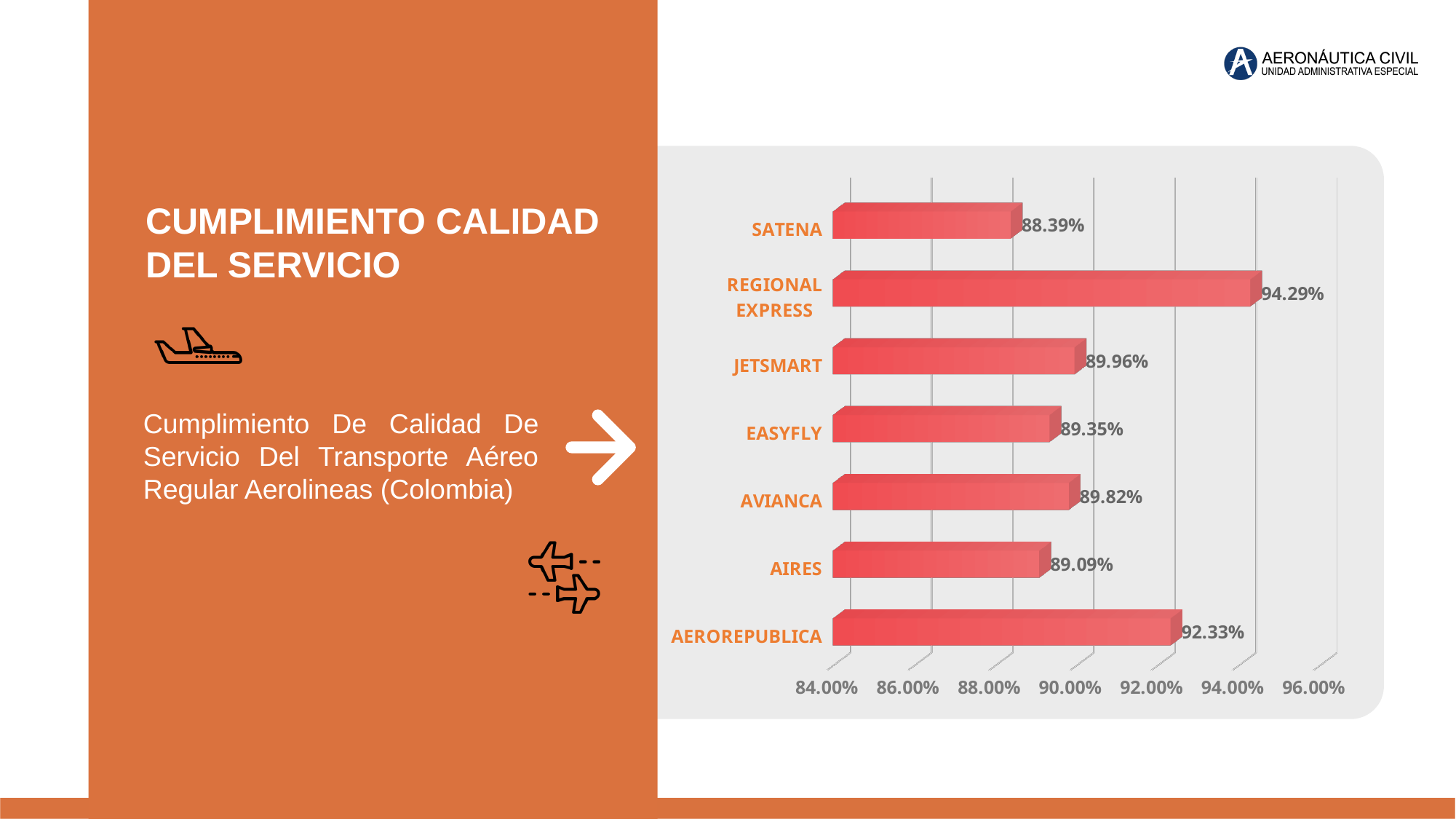
Which is larger, the value for JETSMART or the value for EASYFLY? JETSMART What is the value for AIRES? 89.09% Is the value for AEROREPUBLICA greater or less than 90.00%? greater What is the difference between the values for REGIONAL EXPRESS and SATENA? 5.90% Which airline has the lowest value? SATENA What is the difference between the values for AVIANCA and AIRES? 0.73% What kind of chart is shown on the slide? Bar chart What is the value for AEROREPUBLICA? 92.33% What is the value for SATENA? 88.39% How many airlines are shown in the chart? 7 Which airline has the highest value? REGIONAL EXPRESS What is the value for REGIONAL EXPRESS? 94.29%